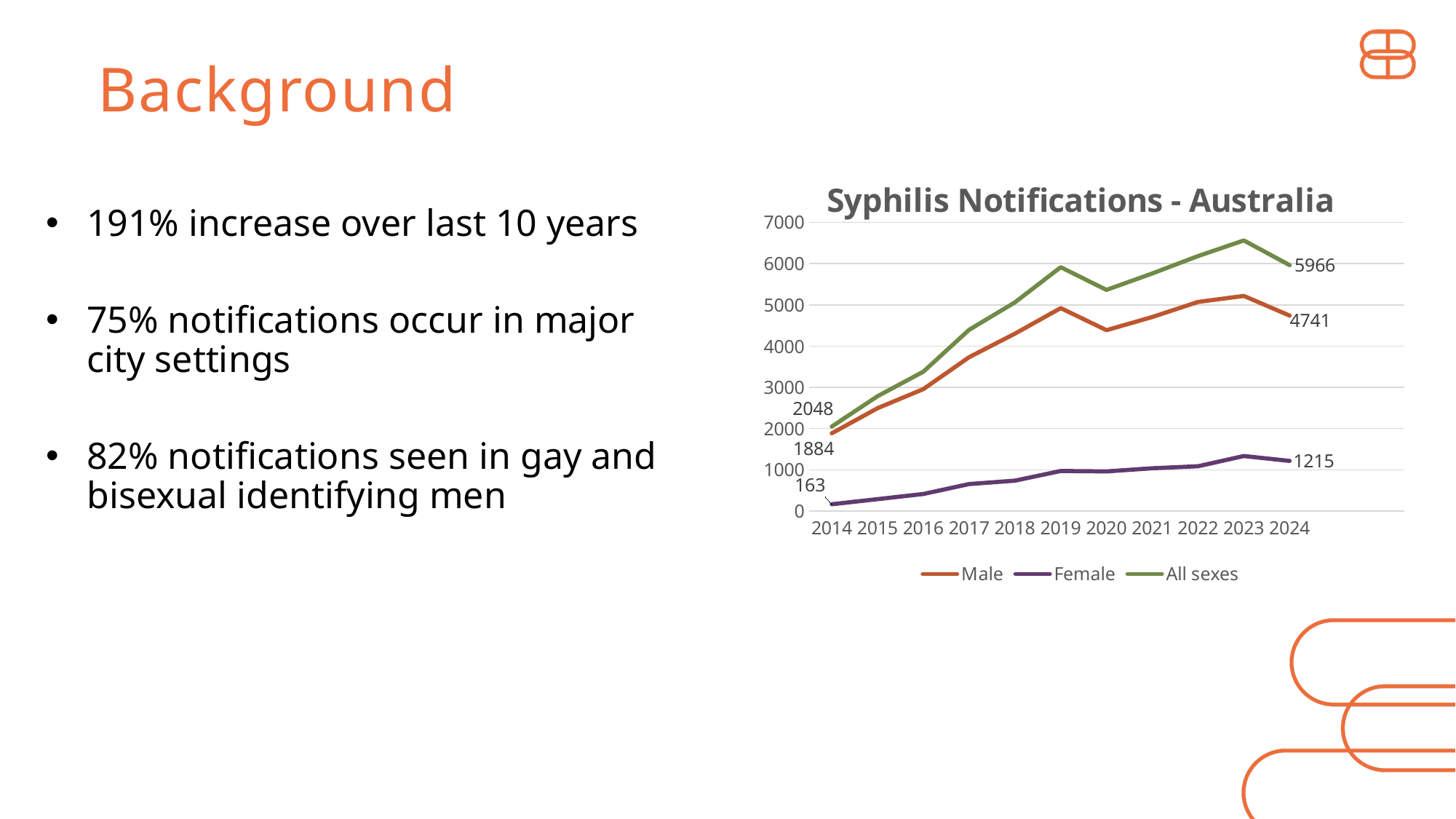
What is the difference between the All sexes values in 2024 and 2014? 3918 What is the value for All sexes in 2024? 5966 Which is larger in 2014, the Male value or the Female value? Male How many years are shown on the x axis? 11 What type of chart is shown on the slide? Line chart Is the value for All sexes in 2023 greater or less than 6000? greater What is the difference between the Male and All sexes values in 2024? 1225 What is the value for Female in 2024? 1215 What is the title of the chart? Syphilis Notifications - Australia How many series does the legend list? 3 What is the value for Male in 2014? 1884 In which year does the All sexes series reach its highest value? 2023